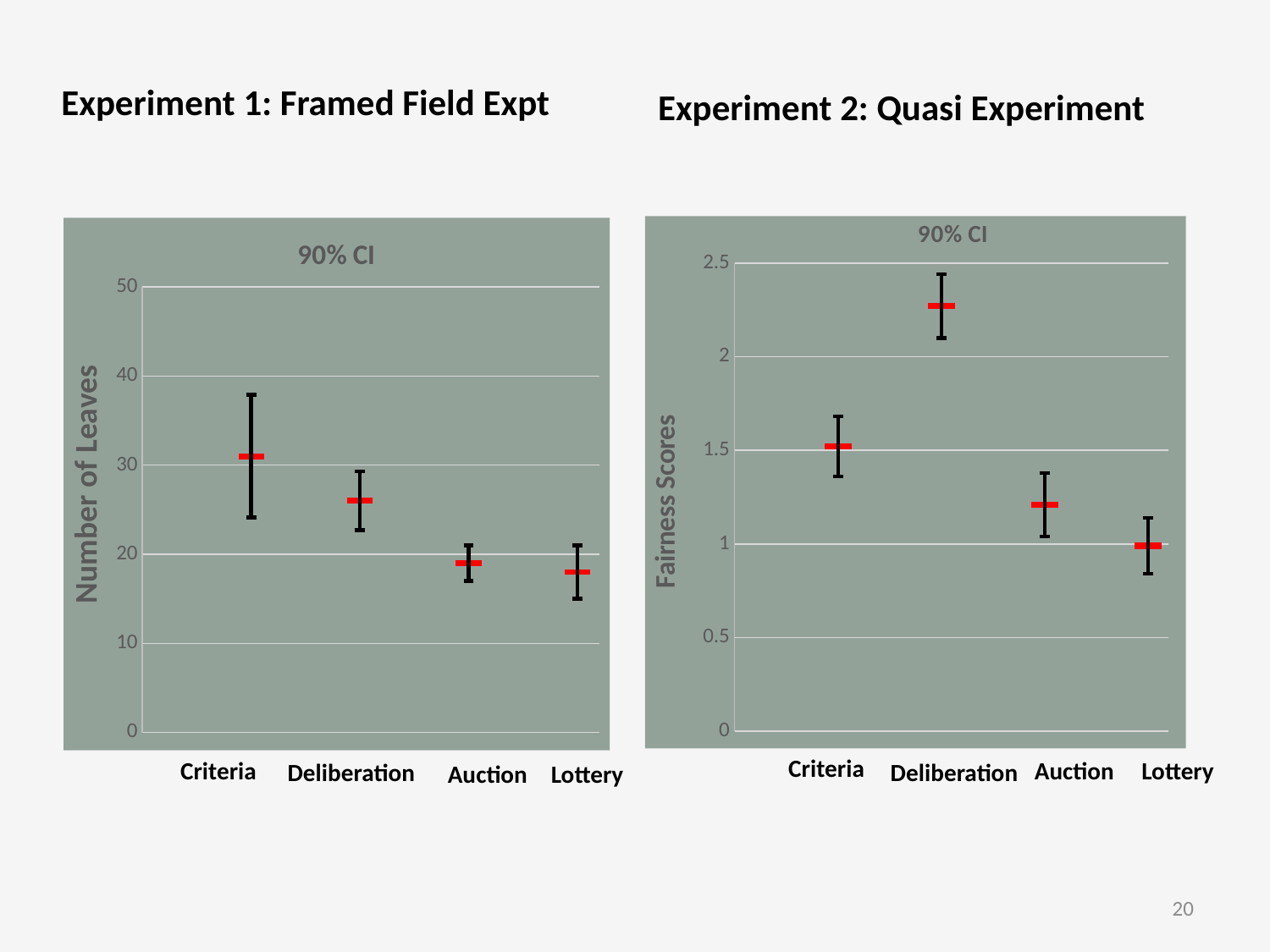
On the Experiment 1: Framed Field Expt chart, is the value for Lottery greater or less than 20? less On the Experiment 1: Framed Field Expt chart, is the value for Criteria greater or less than 40? less On the Experiment 2: Quasi Experiment chart, which category has the lowest value? Lottery What is the y-axis label of the Experiment 1: Framed Field Expt chart? Number of Leaves On the Experiment 1: Framed Field Expt chart, which category has the highest value? Criteria On the Experiment 2: Quasi Experiment chart, which category has the highest value? Deliberation On the Experiment 1: Framed Field Expt chart, is the value for Deliberation greater or less than 20? greater On the Experiment 2: Quasi Experiment chart, is the value for Criteria larger than the value for Auction? Yes How many categories are shown on the x axis of the Experiment 2: Quasi Experiment chart? 4 On the Experiment 1: Framed Field Expt chart, is the value for Criteria larger than the value for Deliberation? Yes